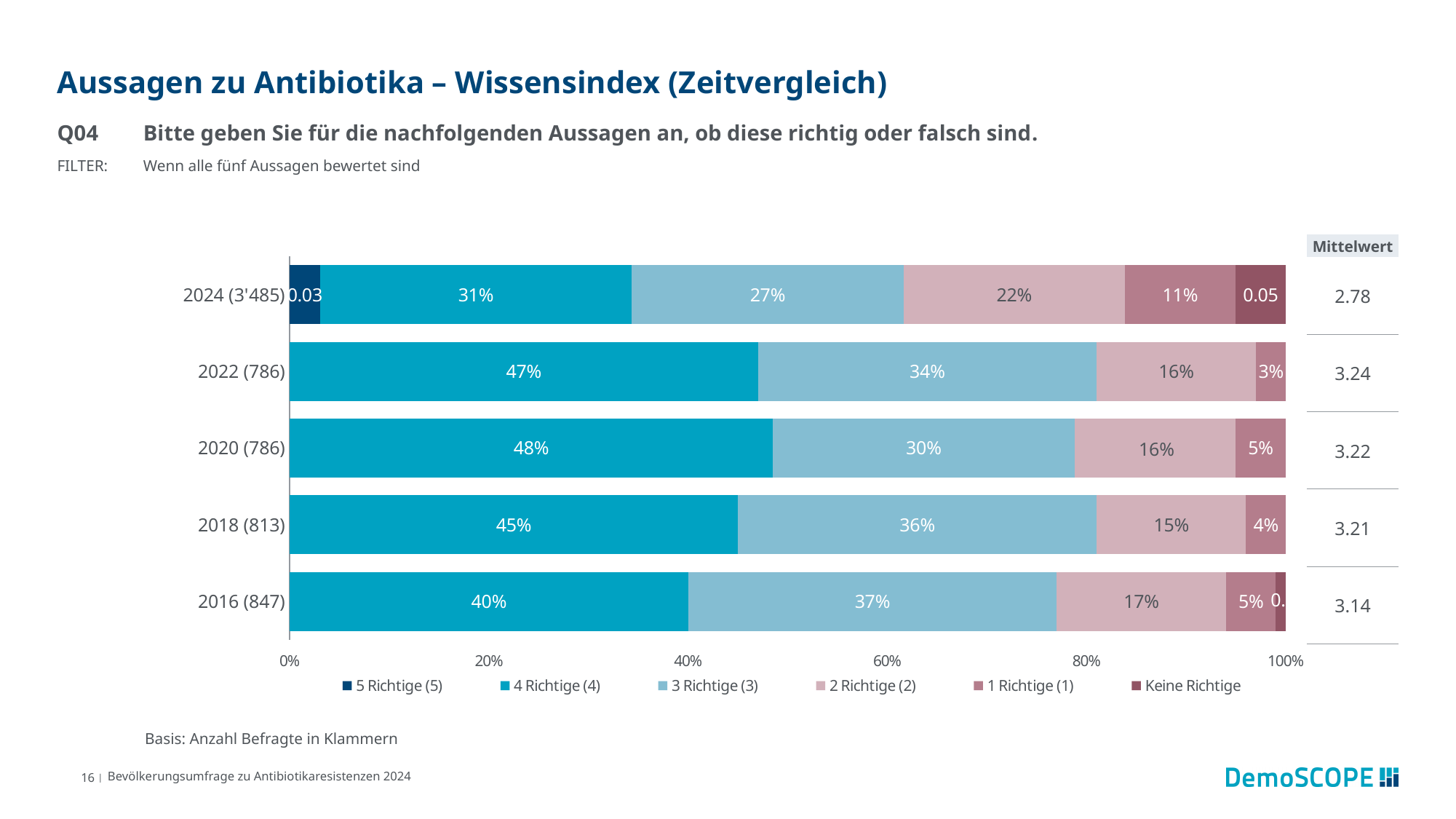
How many years (categories) are shown in the chart? 5 How many series does the legend list? 6 What type of chart is shown on the slide? Stacked bar chart What percentage of respondents in 2024 answered 4 statements correctly (4 Richtige)? 31% Which year has the highest share of '2 Richtige'? 2024 (3'485) What is the Mittelwert (mean) shown for 2022? 3.24 Which year has the lowest share of '4 Richtige'? 2024 (3'485) What is the share of '2 Richtige' for 2024? 22% Which year has the larger share of '2 Richtige': 2016 or 2018? 2016 Which year has the highest share of '4 Richtige'? 2020 (786) By how many percentage points does the '3 Richtige' share in 2018 exceed that in 2024? 9 percentage points What is the share of '3 Richtige' for 2016? 37%